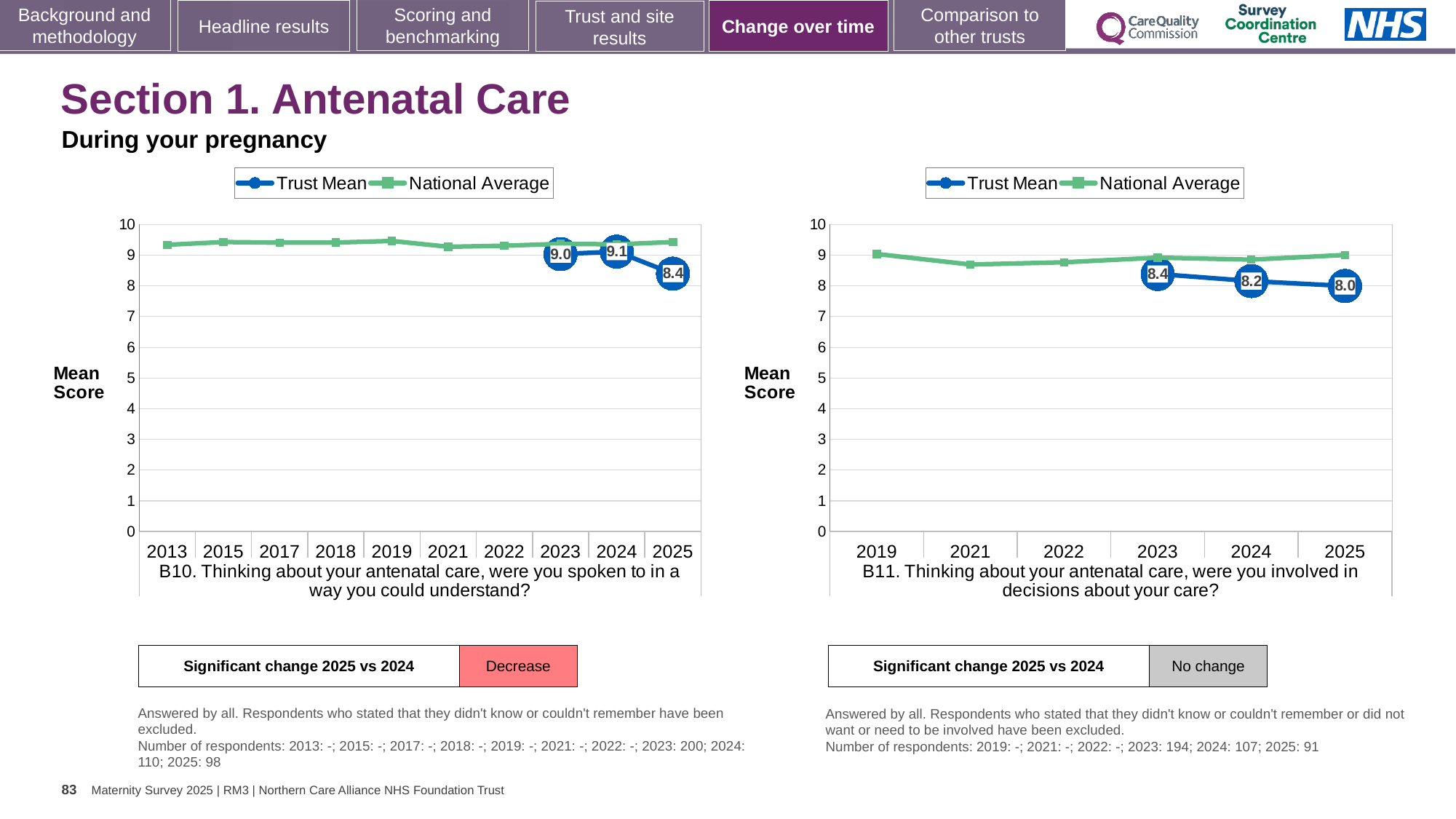
In the B11 chart on the right, what is the Trust Mean for 2023? 8.4 In the B10 chart on the left, what is the Trust Mean for 2024? 9.1 In the B10 chart on the left, by how much did the Trust Mean fall from 2024 to 2025? 0.7 What kind of chart is the B10 chart on the left? line chart How many years are shown on the x axis of the B10 chart on the left? 10 In the B11 chart on the right, what is the Trust Mean for 2025? 8.0 In the B11 chart on the right, is the Trust Mean for 2025 greater or less than 9? less In the B11 chart on the right, what is the difference between the Trust Mean in 2023 and in 2025? 0.4 How many series does the legend of the B11 chart on the right list? 2 In the B10 chart on the left, what is the Trust Mean for 2025? 8.4 In the B11 chart on the right, does the Trust Mean rise or fall from 2023 to 2025? fall In the B10 chart on the left, which year has the highest labelled Trust Mean? 2024